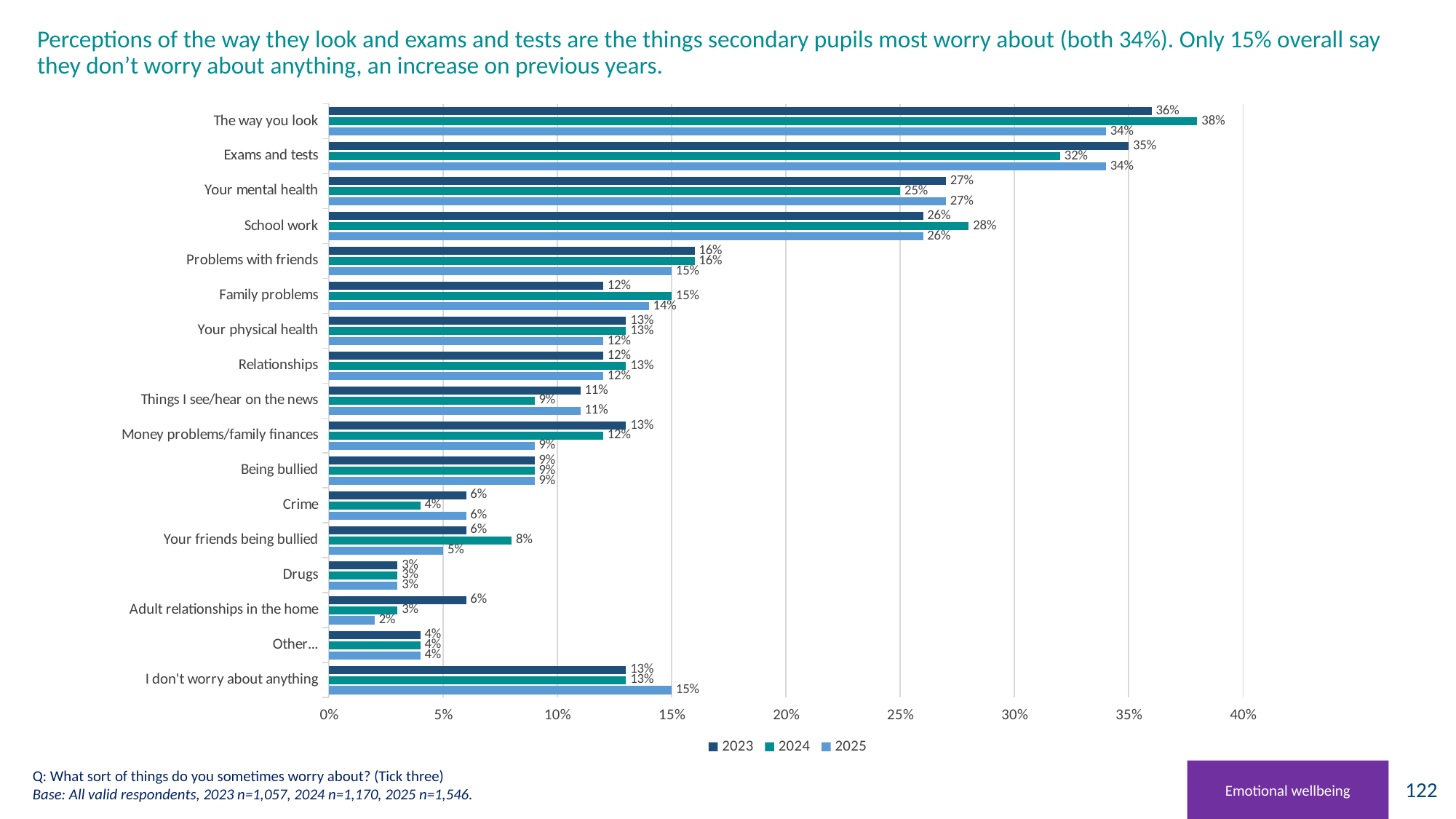
How many categories are shown on the chart? 17 How many series does the legend list? 3 What is the difference between the 2024 and 2025 values for 'The way you look'? 4 percentage points What is the 2025 value for 'Exams and tests'? 34% Do the values for 'Adult relationships in the home' rise or fall from 2023 to 2025? Fall Which is larger in 2024: 'School work' or 'Your mental health'? School work Which category has the lowest 2025 value? Adult relationships in the home What kind of chart is shown on the slide? Bar chart What is the 2023 value for 'Money problems/family finances'? 13% What is the 2024 value for 'The way you look'? 38% Which category has the highest 2024 value? The way you look What are the series listed in the legend? 2023, 2024, 2025